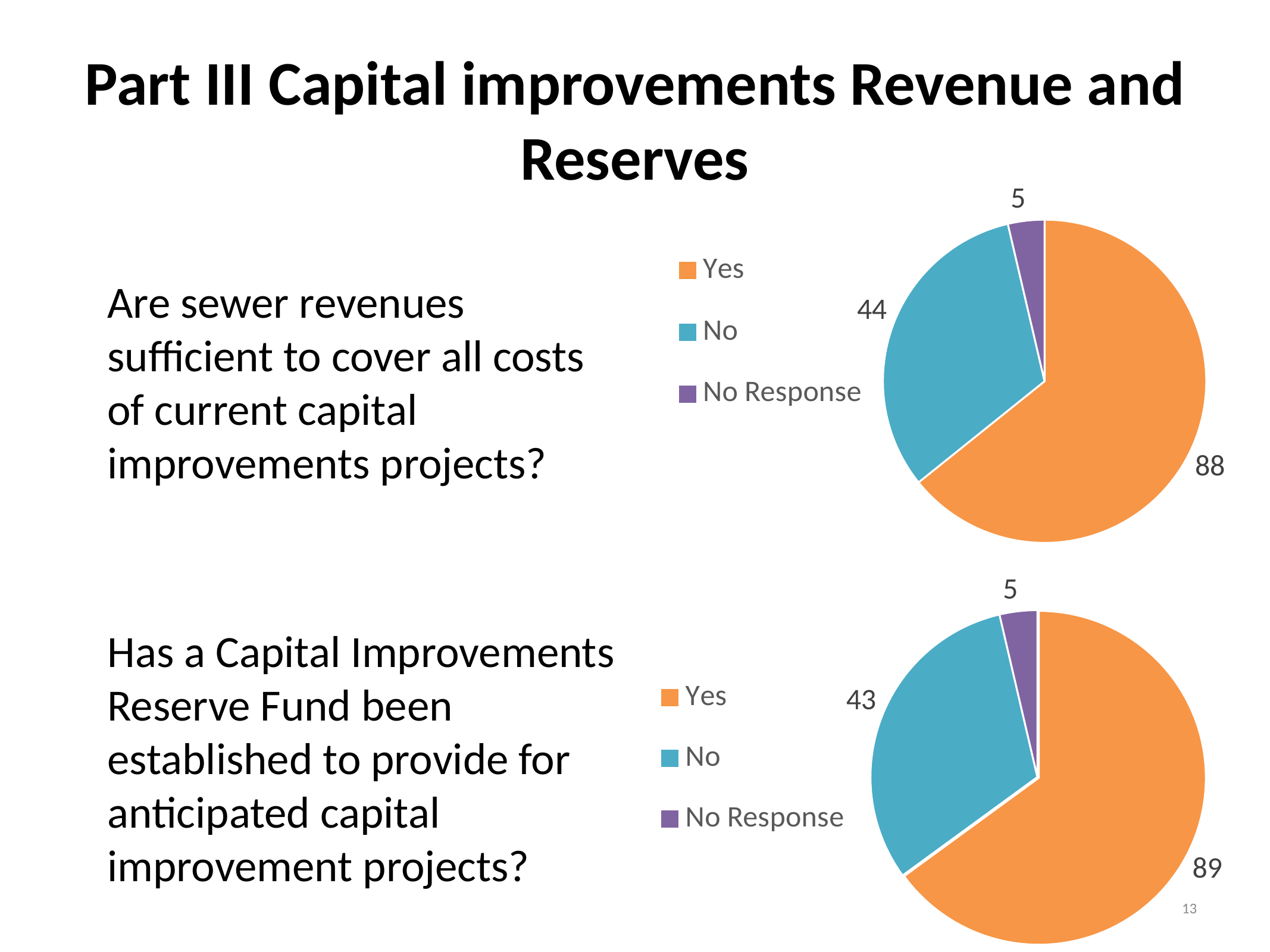
In the top pie chart (sewer revenues sufficient to cover capital improvements costs), what is the difference between the Yes and No values? 44 In the bottom pie chart (Capital Improvements Reserve Fund established), what is the value for Yes? 89 In the bottom pie chart (Capital Improvements Reserve Fund established), which category has the smallest slice? No Response In the top pie chart (sewer revenues sufficient to cover capital improvements costs), what is the value for No? 44 What type of chart is used for the question about the Capital Improvements Reserve Fund? Pie chart In the bottom pie chart (Capital Improvements Reserve Fund established), which is larger, Yes or No? Yes How many slices does the top pie chart (sewer revenues sufficient to cover capital improvements costs) have? 3 In the bottom pie chart (Capital Improvements Reserve Fund established), what is the value for No Response? 5 In the bottom pie chart (Capital Improvements Reserve Fund established), what is the difference between the Yes and No values? 46 In the top pie chart (sewer revenues sufficient to cover capital improvements costs), which category has the largest slice? Yes In the top pie chart (sewer revenues sufficient to cover capital improvements costs), what colour is the No slice? Blue In the top pie chart (sewer revenues sufficient to cover capital improvements costs), what is the value for Yes? 88